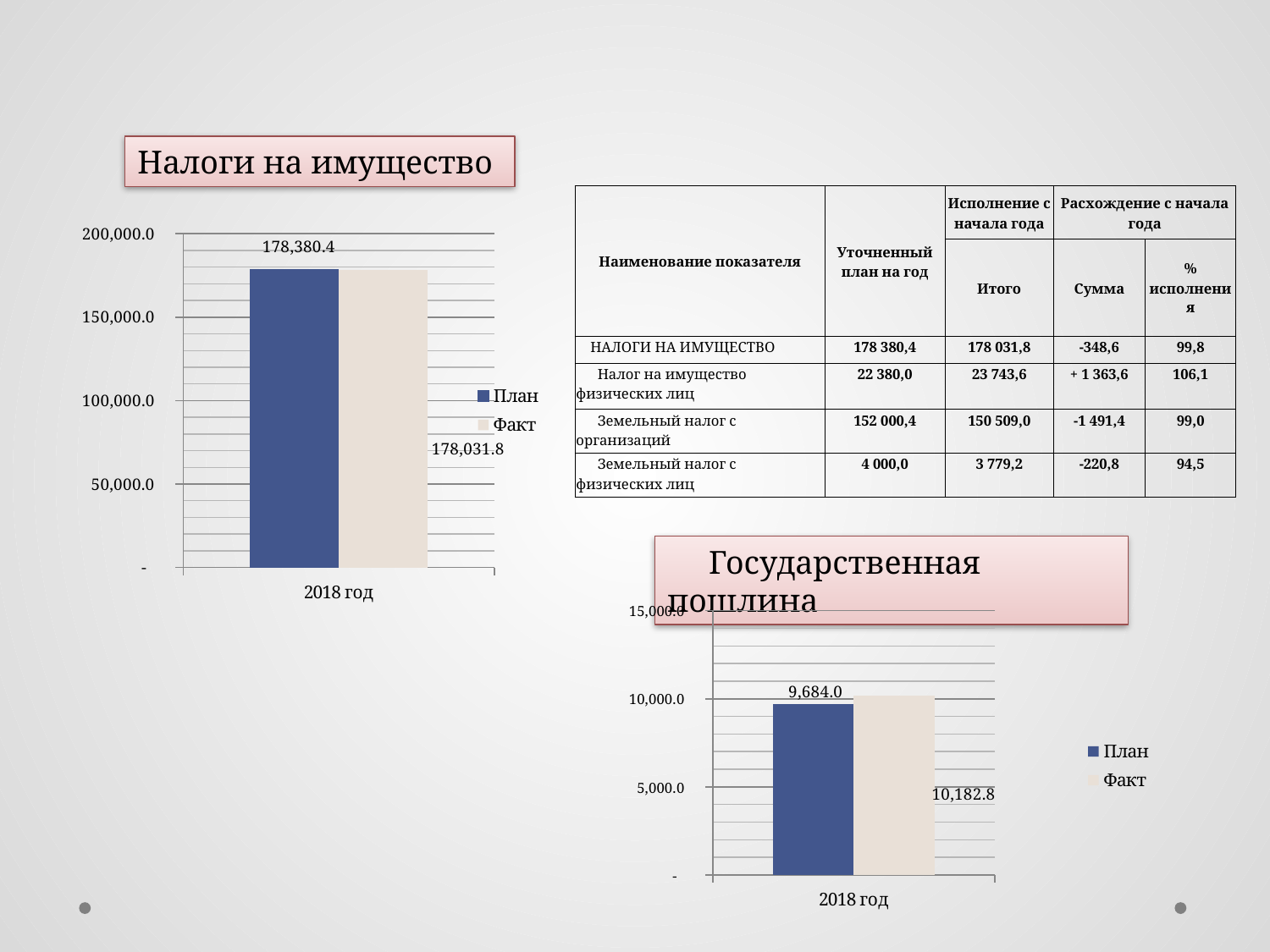
What kind of chart is the 'Налоги на имущество' chart? bar chart In the 'Государственная пошлина' chart, what is the value for План in 2018 год? 9,684.0 In the 'Налоги на имущество' chart, what is the value for План in 2018 год? 178,380.4 In the 'Налоги на имущество' chart, what is the value for Факт in 2018 год? 178,031.8 In the 'Государственная пошлина' chart, is the value for План greater or less than 10,000.0? less In the 'Государственная пошлина' chart, what is the difference between Факт and План? 498.8 In the 'Налоги на имущество' chart, is the value for План greater or less than 150,000.0? greater In the 'Государственная пошлина' chart, which is larger, План or Факт? Факт In the 'Государственная пошлина' chart, what is the value for Факт in 2018 год? 10,182.8 How many categories are shown on the x axis of the 'Государственная пошлина' chart? 1 How many series does the legend of the 'Налоги на имущество' chart list? 2 In the 'Налоги на имущество' chart, what is the difference between План and Факт? 348.6